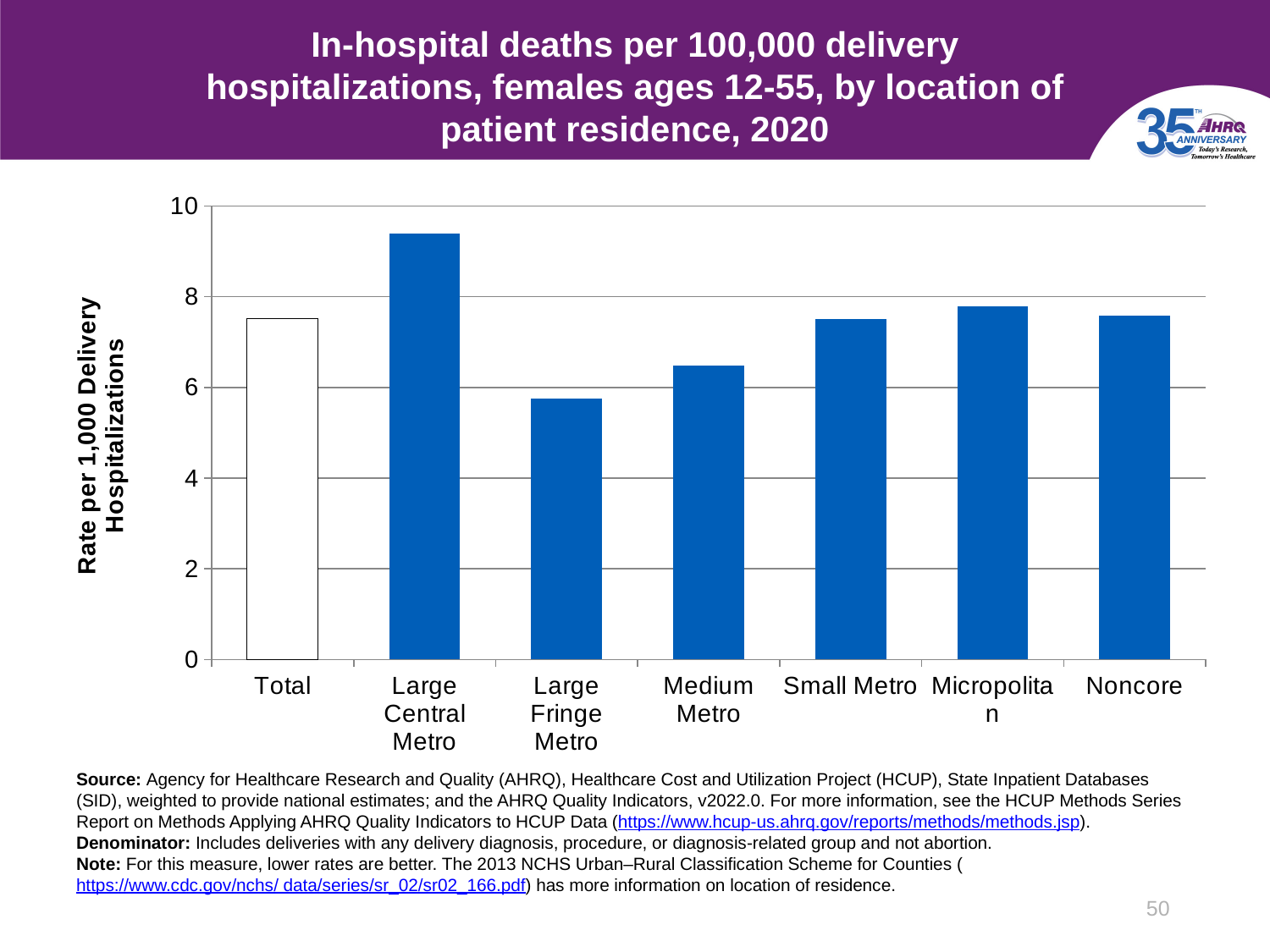
Which is larger, the value for Large Fringe Metro or the value for Small Metro? Small Metro Is the value for Medium Metro greater or less than 6? greater What is the label on the y axis of the chart? Rate per 1,000 Delivery Hospitalizations Is the value for Large Fringe Metro greater or less than 6? less Is the value for Noncore greater or less than 6? greater Which location of patient residence has the lowest rate? Large Fringe Metro How many categories are plotted on the x axis? 7 Which is larger, the value for Large Central Metro or the value for Medium Metro? Large Central Metro Which location of patient residence has the highest rate? Large Central Metro What kind of chart is shown on the slide? bar chart